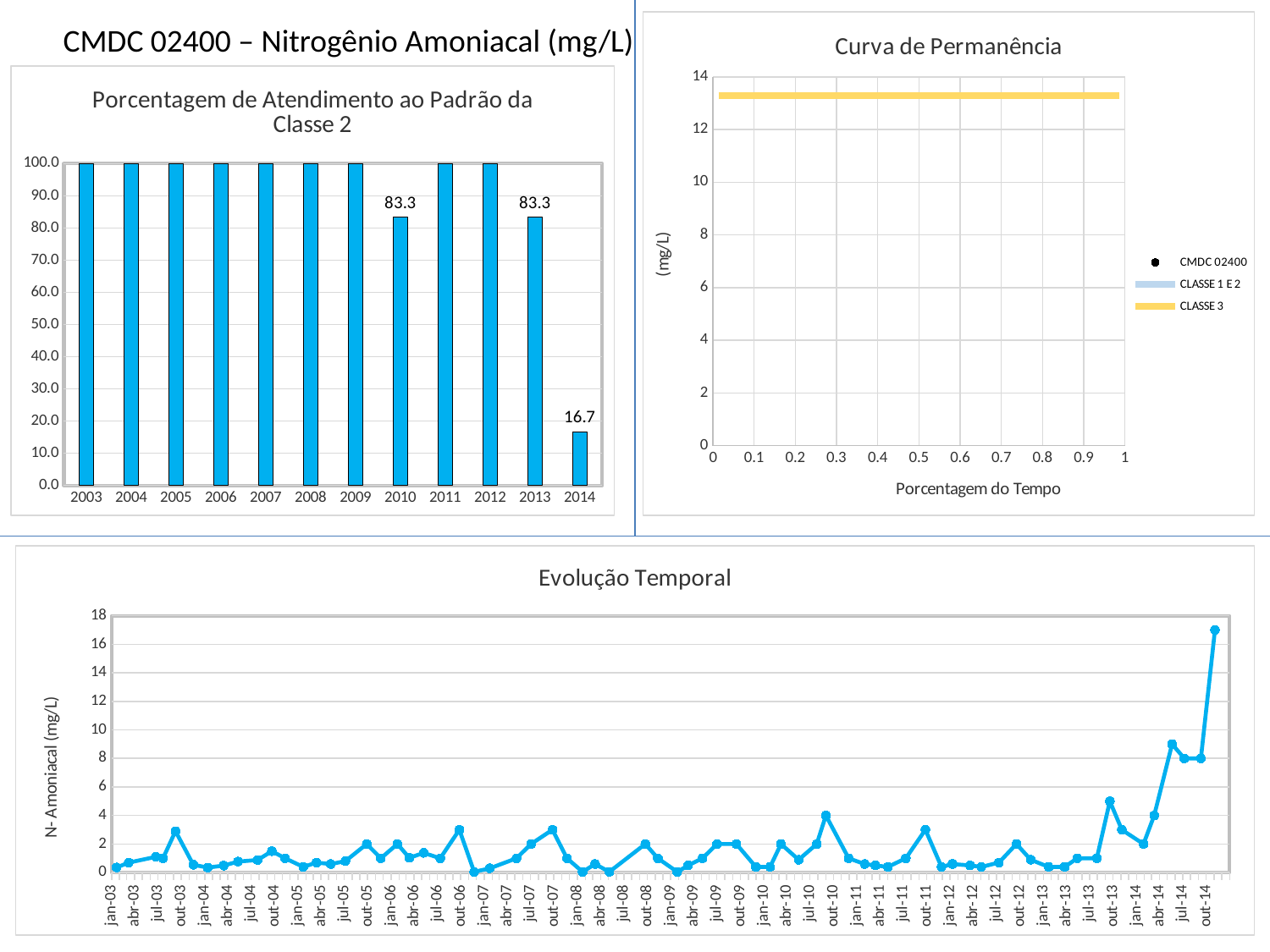
In the chart 'Porcentagem de Atendimento ao Padrão da Classe 2', what is the value for 2010? 83.3 In the chart 'Porcentagem de Atendimento ao Padrão da Classe 2', which is larger, the value for 2013 or the value for 2014? 2013 In the chart 'Curva de Permanência', is the CLASSE 3 line greater or less than 12? greater What kind of chart is 'Porcentagem de Atendimento ao Padrão da Classe 2'? Bar chart In the chart 'Evolução Temporal', is the value for out-14 greater or less than 14? greater In the chart 'Porcentagem de Atendimento ao Padrão da Classe 2', which year has the lowest value? 2014 How many series does the legend of the chart 'Curva de Permanência' list? 3 In the chart 'Porcentagem de Atendimento ao Padrão da Classe 2', what is the value for 2014? 16.7 In the chart 'Porcentagem de Atendimento ao Padrão da Classe 2', what is the difference between the values for 2010 and 2014? 66.6 In the chart 'Porcentagem de Atendimento ao Padrão da Classe 2', what is the value for 2013? 83.3 How many years are shown in the chart 'Porcentagem de Atendimento ao Padrão da Classe 2'? 12 What is the x-axis title of the chart 'Curva de Permanência'? Porcentagem do Tempo